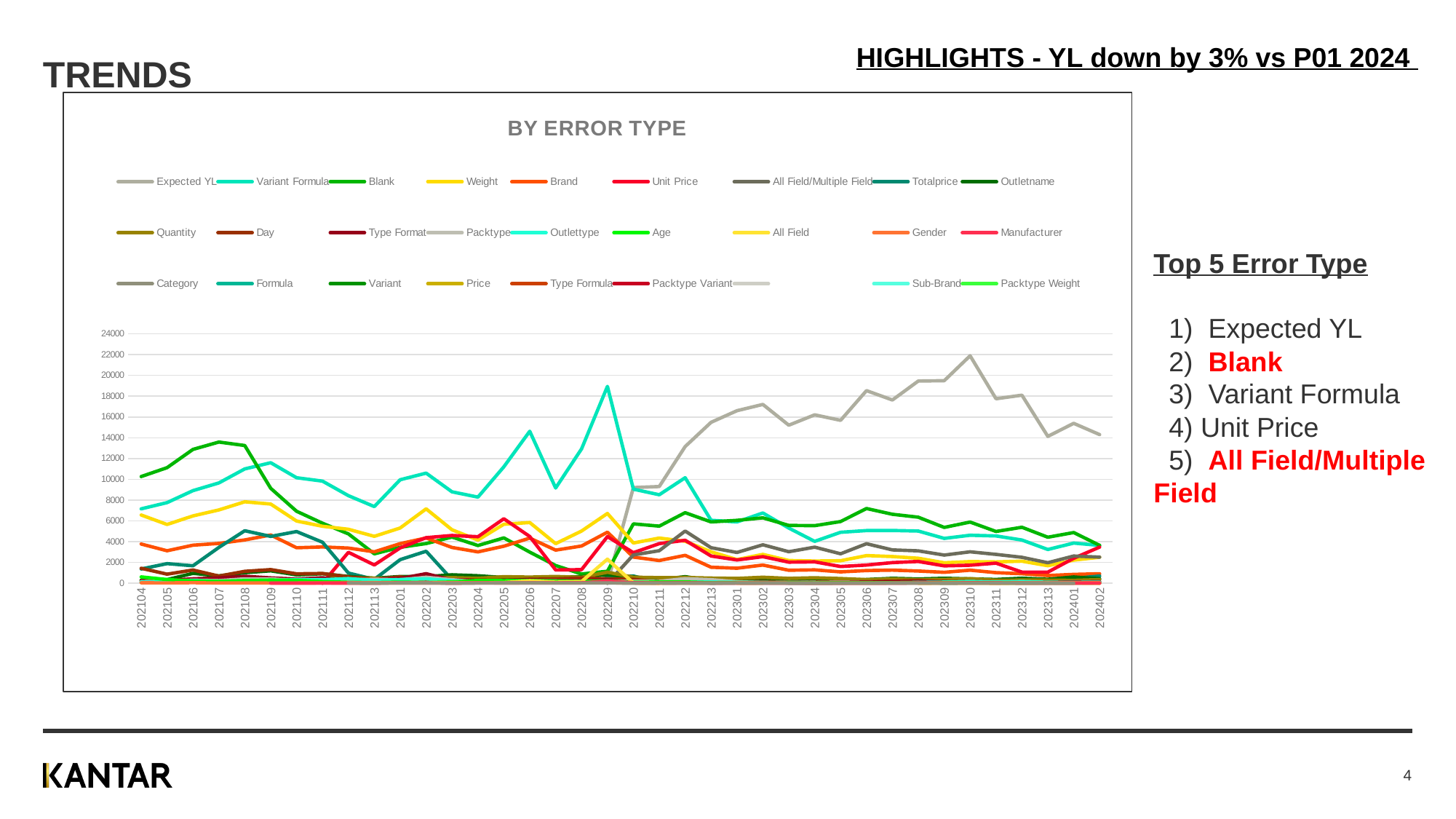
In which period does the Expected YL line reach its highest value? 202310 Is the value for Expected YL at 202310 greater or less than 20000? greater Does the Blank line rise or fall between 202108 and 202113? fall Is the value for Blank at 202107 greater or less than 12000? greater Does the Expected YL line rise or fall between 202210 and 202310? rise At 202209, which is larger: the Variant Formula value or the Blank value? Variant Formula How many periods are shown along the x axis of the chart? 38 What is the title of the chart? BY ERROR TYPE What kind of chart is shown on the slide? line chart Is the value for Variant Formula at 202209 greater or less than 18000? greater Which series reaches the highest value anywhere on the chart? Expected YL